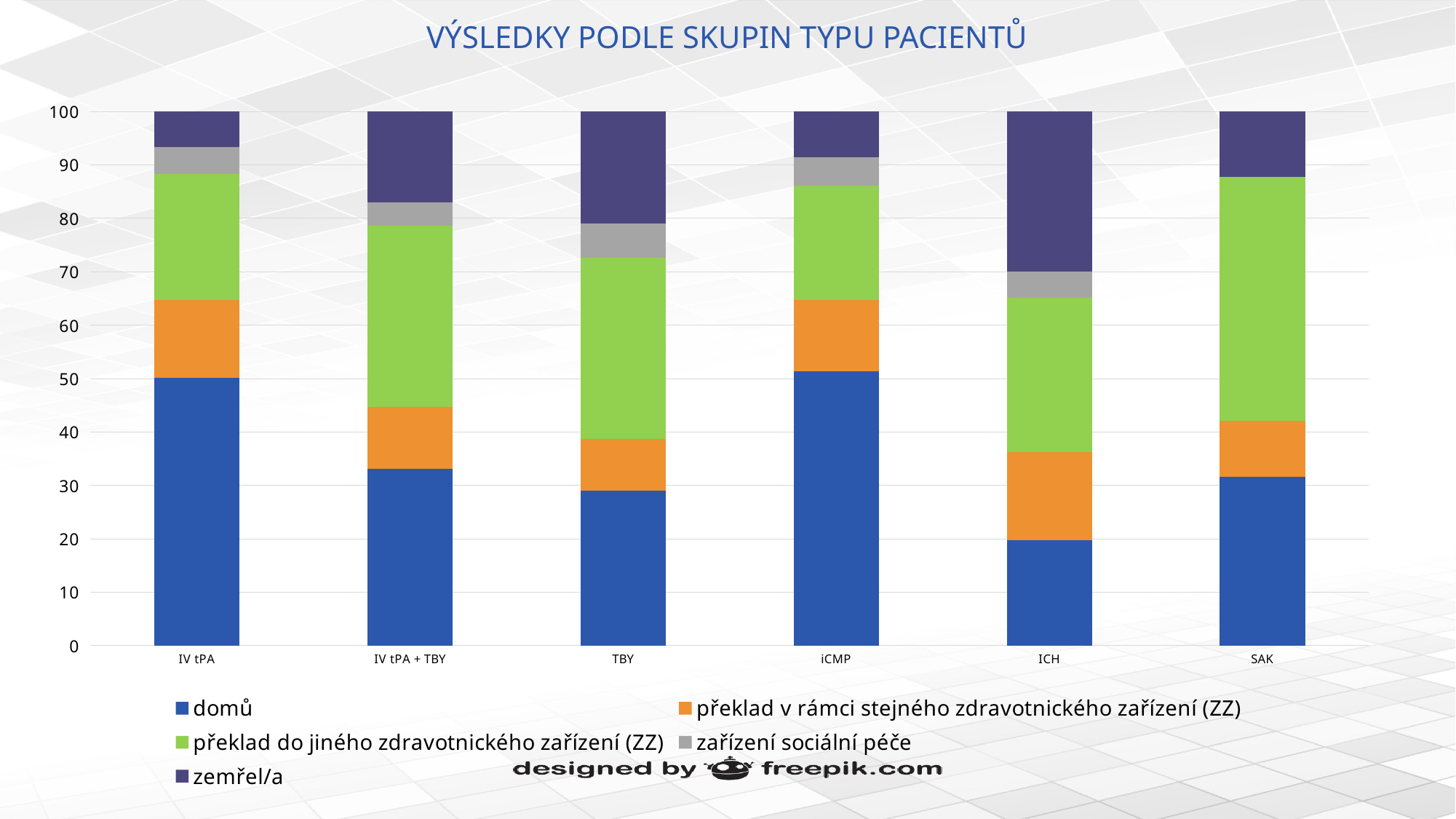
How many patient groups (categories) are shown on the x axis? 6 Which patient group has the highest value for 'zemřel/a'? ICH Is the value for 'domů' in the SAK group greater or less than 40? less What is the total height of the IV tPA stacked bar? 100 Which patient group has the highest value for 'překlad do jiného zdravotnického zařízení (ZZ)'? SAK What is the title of the chart? VÝSLEDKY PODLE SKUPIN TYPU PACIENTŮ Which has the larger 'domů' value, IV tPA + TBY or TBY? IV tPA + TBY What kind of chart is shown on the slide? stacked bar chart How many series does the legend list? 5 Is the value for 'domů' in the IV tPA group greater or less than 40? greater Which patient group has the lowest value for 'domů'? ICH Is the value for 'domů' in the ICH group greater or less than 30? less